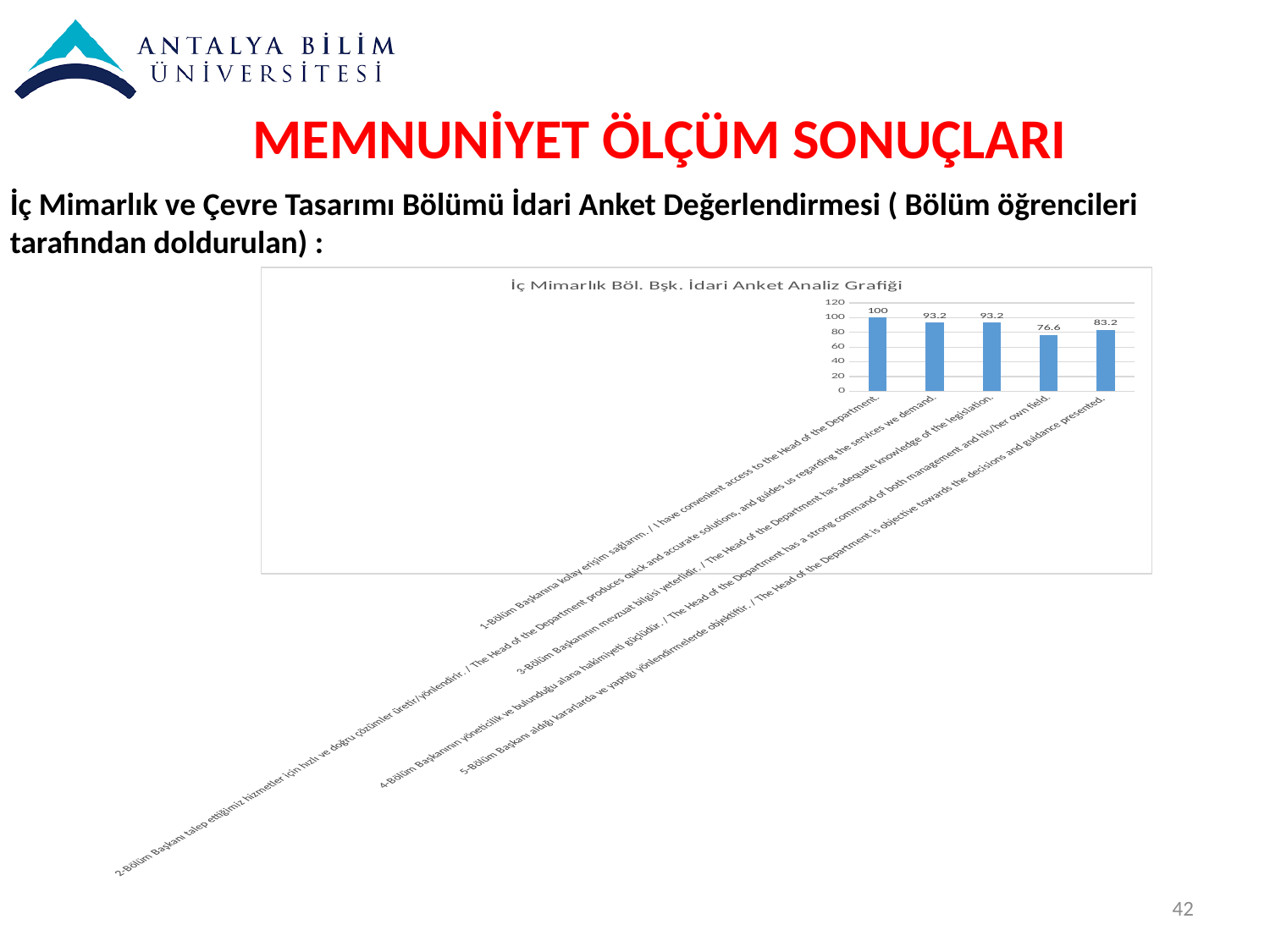
Which item has the highest value in the chart? 1-Bölüm Başkanına kolay erişim sağlarım. / I have convenient access to the Head of the Department. Which item has the lowest value in the chart? 4-Bölüm Başkanının yöneticilik ve bulunduğu alana hakimiyeti güçlüdür. / The Head of the Department has a strong command of both management and his/her own field. What is the maximum value shown on the vertical axis of the chart? 120 How many bars are plotted in the chart? 5 What is the value for item 1 (I have convenient access to the Head of the Department)? 100 Which is larger, the value for item 5 or the value for item 4? item 5 What is the value for item 5 (The Head of the Department is objective towards the decisions and guidance presented)? 83.2 What is the value for item 4 (The Head of the Department has a strong command of both management and his/her own field)? 76.6 What is the difference between the value for item 1 and the value for item 4? 23.4 What is the value for item 3 (The Head of the Department has adequate knowledge of the legislation)? 93.2 What is the title of the chart? İç Mimarlık Böl. Bşk. İdari Anket Analiz Grafiği What type of chart is shown on the slide? bar chart